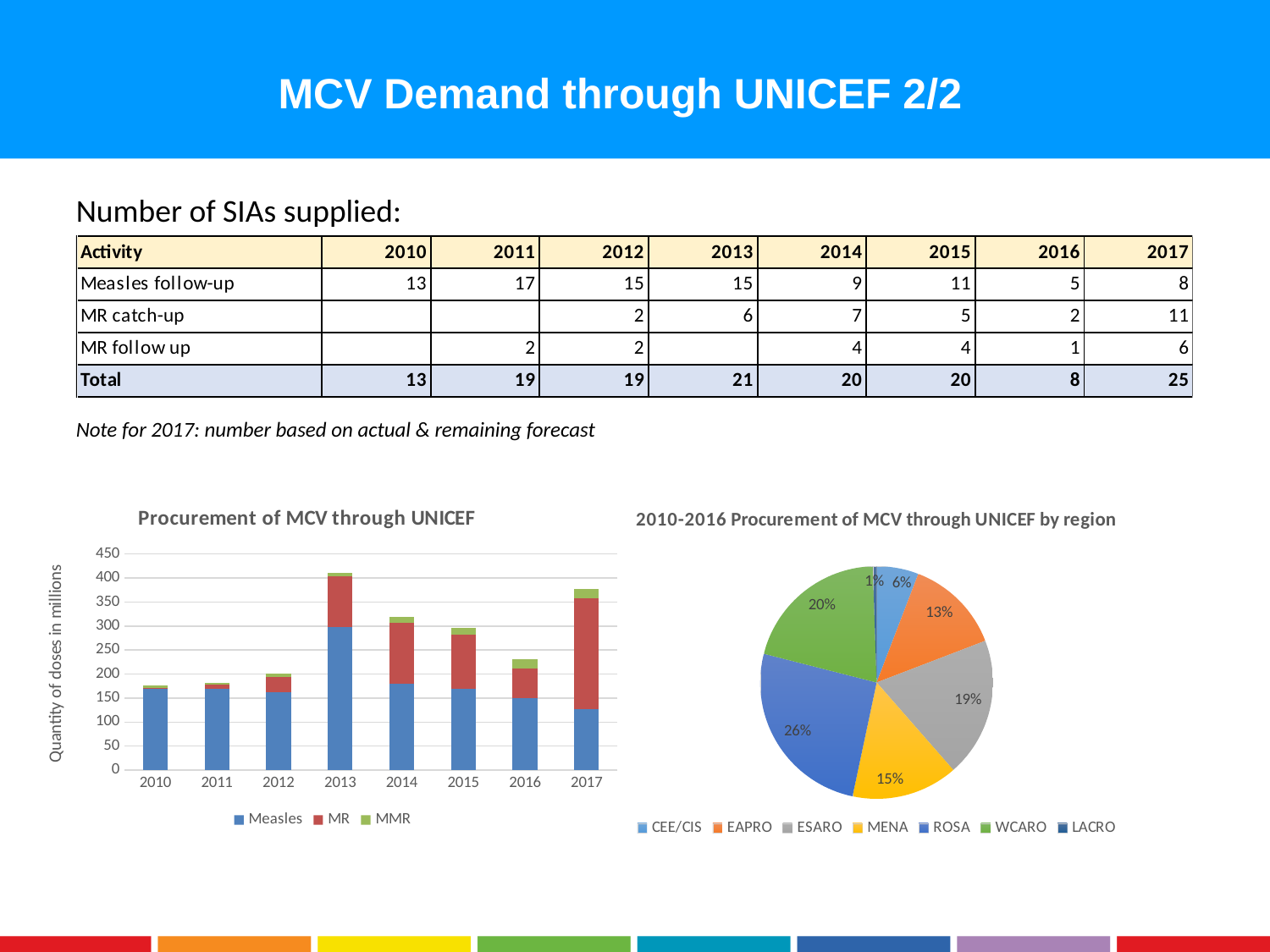
How many regions are shown in the legend of the pie chart '2010-2016 Procurement of MCV through UNICEF by region'? 7 In the pie chart '2010-2016 Procurement of MCV through UNICEF by region', what share does ROSA have? 26% In the bar chart 'Procurement of MCV through UNICEF', is the total for 2010 greater or less than 200? less In the bar chart 'Procurement of MCV through UNICEF', which year has the tallest total bar? 2013 In the pie chart '2010-2016 Procurement of MCV through UNICEF by region', what share does ESARO have? 19% In the pie chart '2010-2016 Procurement of MCV through UNICEF by region', what share does WCARO have? 20% In the bar chart 'Procurement of MCV through UNICEF', is the total for 2013 greater or less than 400? greater What type of chart is 'Procurement of MCV through UNICEF'? Stacked bar chart In the pie chart '2010-2016 Procurement of MCV through UNICEF by region', what is the difference between the shares of EAPRO and CEE/CIS? 7% In the pie chart '2010-2016 Procurement of MCV through UNICEF by region', which region has the smallest share? LACRO In the pie chart '2010-2016 Procurement of MCV through UNICEF by region', which region has the largest share? ROSA How many series does the legend of the bar chart 'Procurement of MCV through UNICEF' list? 3